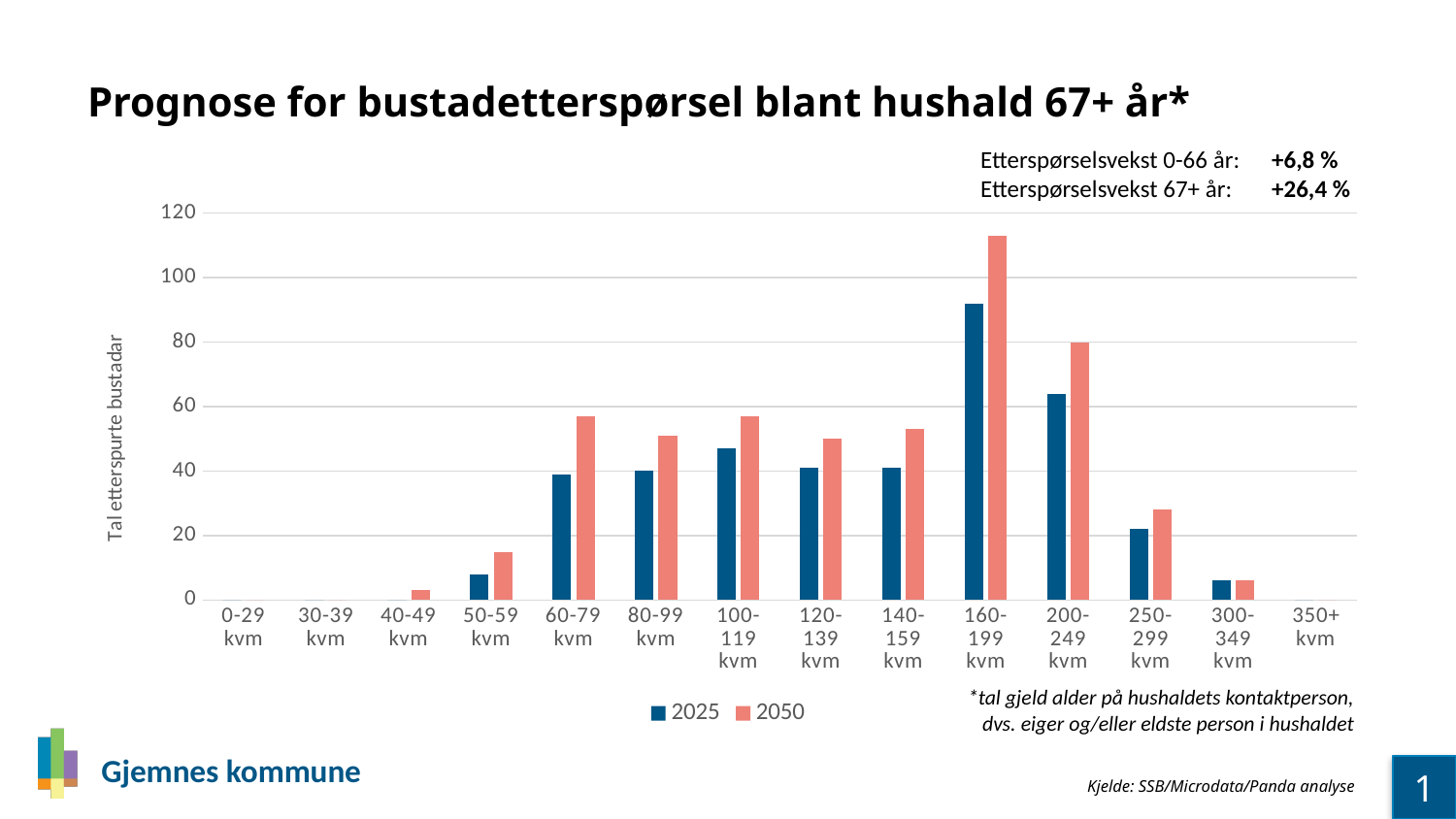
How many series does the legend list? 2 Is the 2025 value for 200-249 kvm greater or less than 60? greater What kind of chart is shown on the slide? bar chart Is the 2050 value for 160-199 kvm greater or less than 100? greater Which size category has the highest value for the 2025 series? 160-199 kvm Is the 2025 value for 160-199 kvm greater or less than 100? less Which size category has the highest value for the 2050 series? 160-199 kvm Which is larger: the 2050 value for 200-249 kvm or the 2050 value for 100-119 kvm? 200-249 kvm How many size categories are shown on the x axis? 14 For 60-79 kvm, which series has the larger value, 2025 or 2050? 2050 What is the title of the chart? Prognose for bustadetterspørsel blant hushald 67+ år*